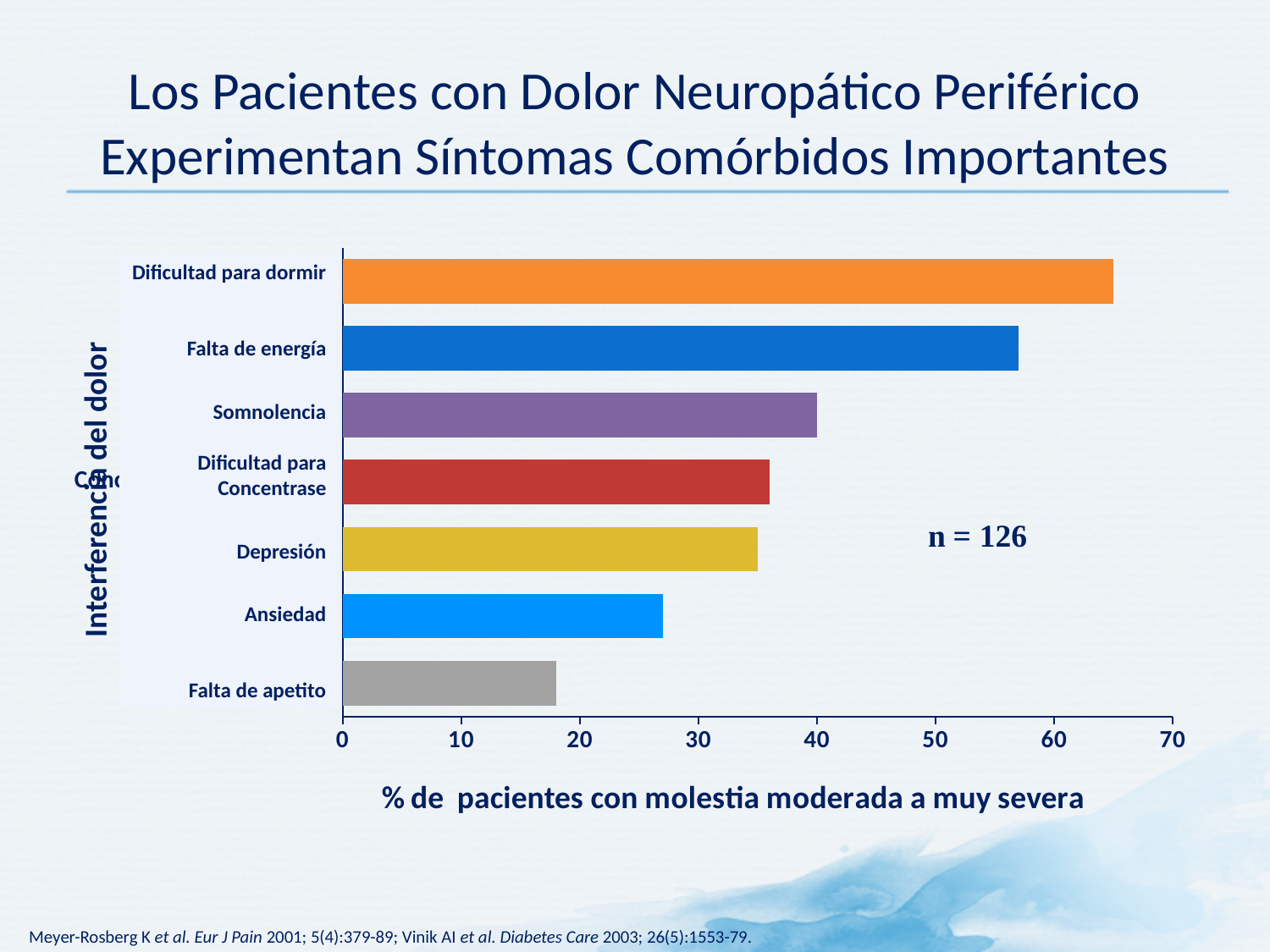
Is the value for Ansiedad greater or less than 30? less Which has a larger value, Ansiedad or Depresión? Depresión Is the value for Falta de apetito greater or less than 20? less Is the value for Falta de energía greater or less than 50? greater What kind of chart is shown on the slide? bar chart What is the label of the horizontal axis of the chart? % de pacientes con molestia moderada a muy severa Which has a larger value, Dificultad para dormir or Falta de energía? Dificultad para dormir How many symptom categories are plotted in the chart? 7 Which symptom has the highest percentage of patients with moderate to very severe discomfort? Dificultad para dormir Which symptom has the lowest percentage of patients with moderate to very severe discomfort? Falta de apetito What sample size (n) is shown on the chart? n = 126